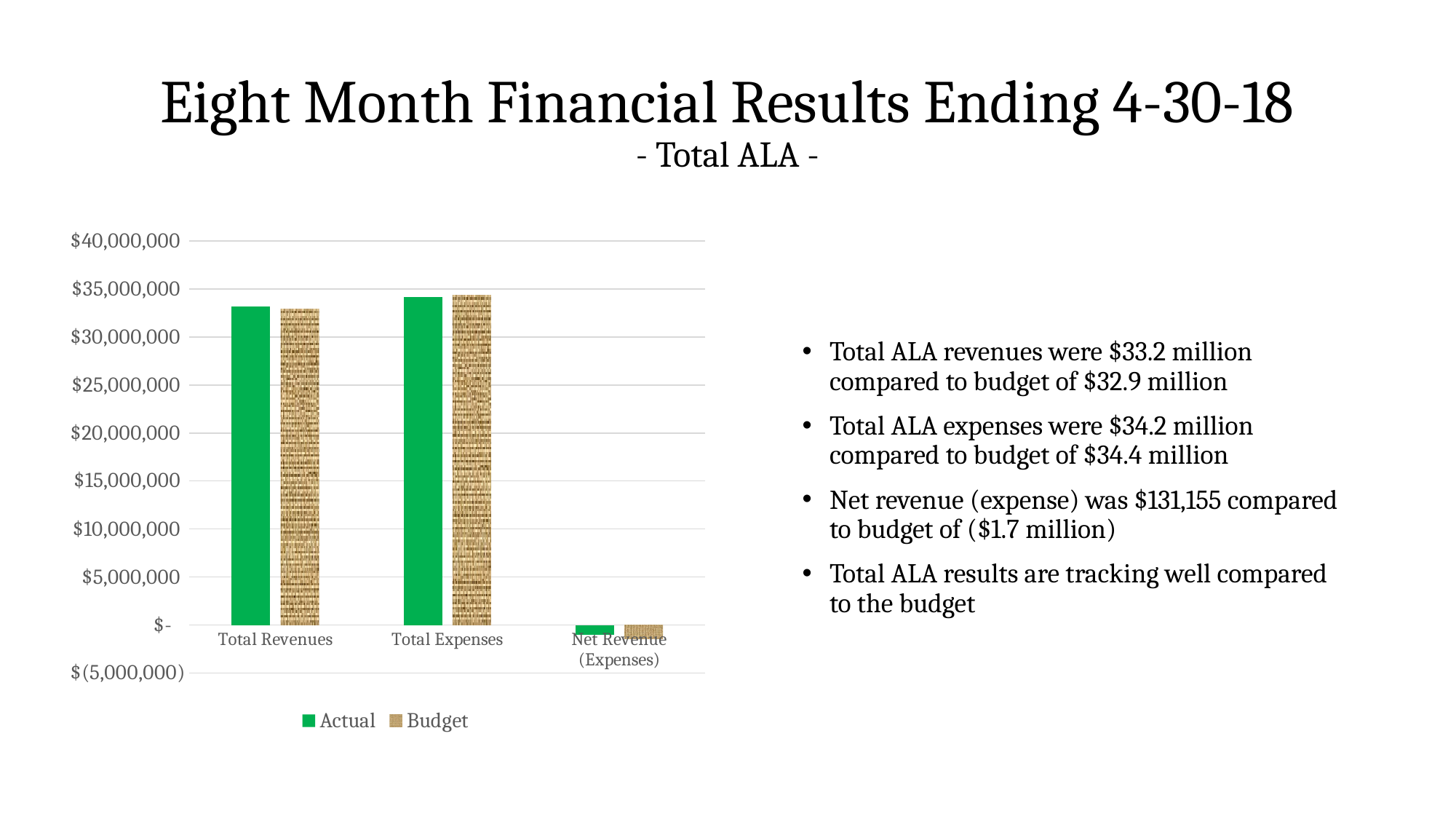
Is the Budget value for Total Expenses greater or less than $35,000,000? less According to the slide, what was the budget for total ALA expenses? $34.4 million How many series does the chart legend list? 2 Which category has the lowest Actual value in the chart? Net Revenue (Expenses) What are the two series named in the chart legend? Actual and Budget How many categories are shown on the x axis of the chart? 3 Is the Actual value for Total Revenues greater or less than $30,000,000? greater Which category has the highest Actual value in the chart? Total Expenses Which is larger for Total Revenues, the Actual value or the Budget value? Actual According to the slide, what were total ALA revenues (Actual)? $33.2 million What type of chart is shown on the slide? bar chart Is the Actual value for Net Revenue (Expenses) greater or less than $5,000,000? less